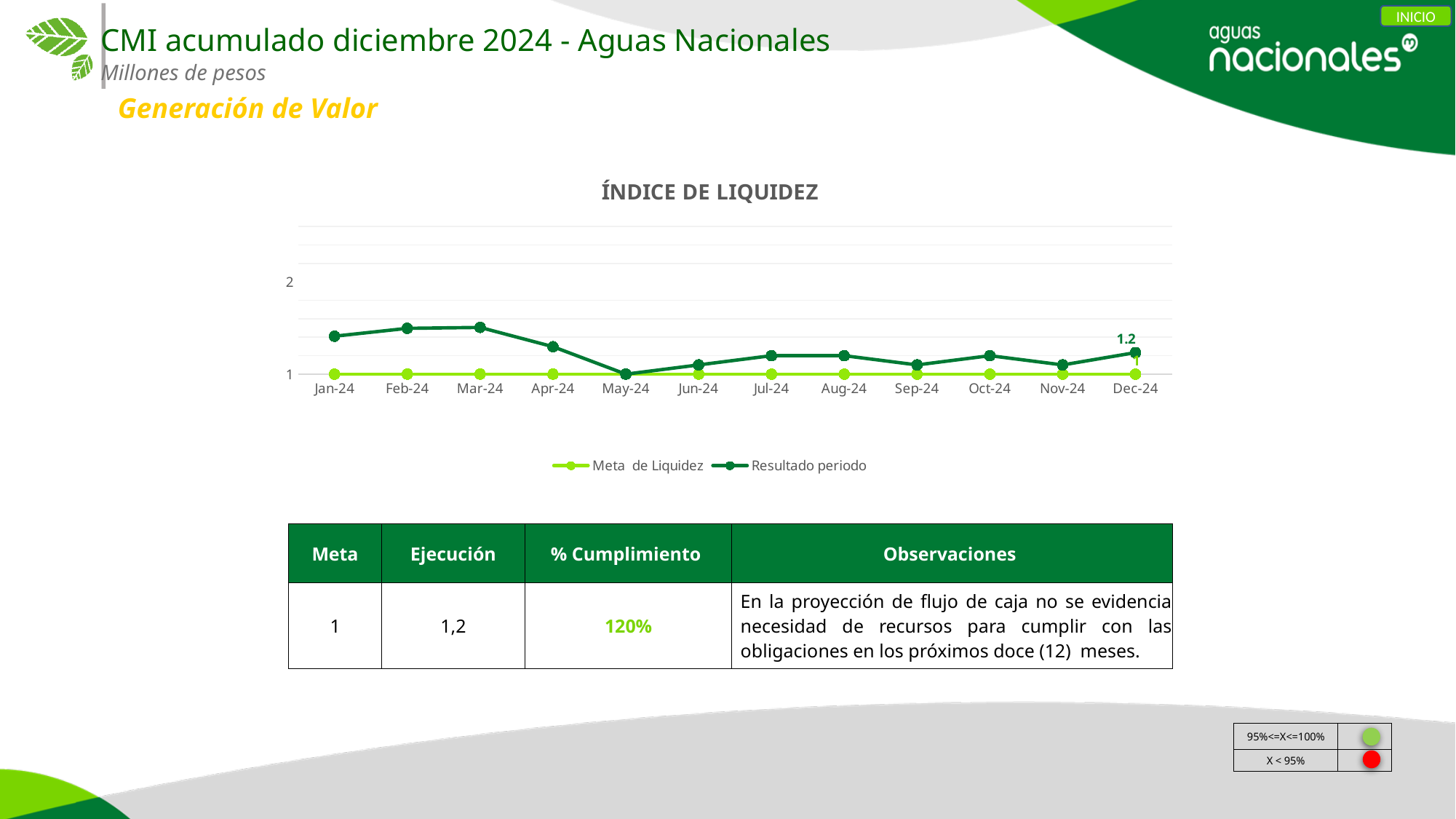
How many months are plotted along the x axis of the chart? 12 Which is higher for Resultado periodo: Jan-24 or Apr-24? Jan-24 Does Resultado periodo rise or fall from Mar-24 to May-24? Fall What are the two series named in the chart legend? Meta de Liquidez and Resultado periodo By how much does Resultado periodo exceed Meta de Liquidez in Dec-24? 0.2 How many series does the chart legend list? 2 What is the value of Meta de Liquidez in Jan-24? 1 What kind of chart is shown under the title ÍNDICE DE LIQUIDEZ? Line chart Is the value for Resultado periodo in Mar-24 greater or less than 2? less What is the title of the chart on the slide? ÍNDICE DE LIQUIDEZ In which month is Resultado periodo at its lowest? May-24 What is the value of Resultado periodo in Dec-24? 1.2